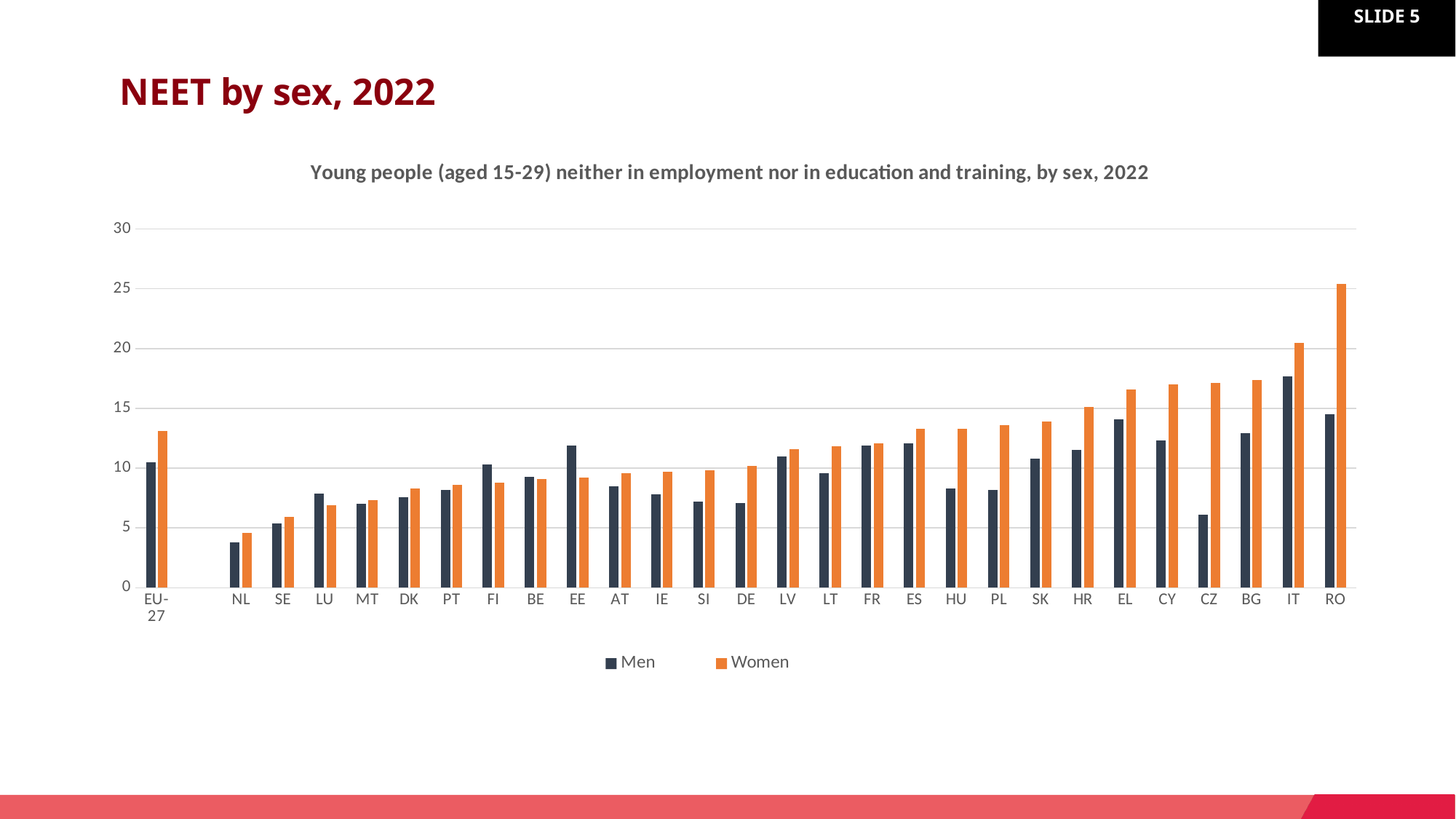
Is the value for Women in EU-27 greater or less than 10? greater In FI, which is larger, the value for Men or the value for Women? Men Which country has the lowest value for Men? NL Do the values for Women generally rise or fall from left to right across the countries? rise Which country has the highest value for Men? IT Is the value for Women in RO greater or less than 20? greater Which country has the lowest value for Women? NL Is the value for Men in CZ greater or less than 10? less What kind of chart is shown on the slide? bar chart Which country has the highest value for Women? RO How many series does the legend list? 2 In CZ, which is larger, the value for Men or the value for Women? Women